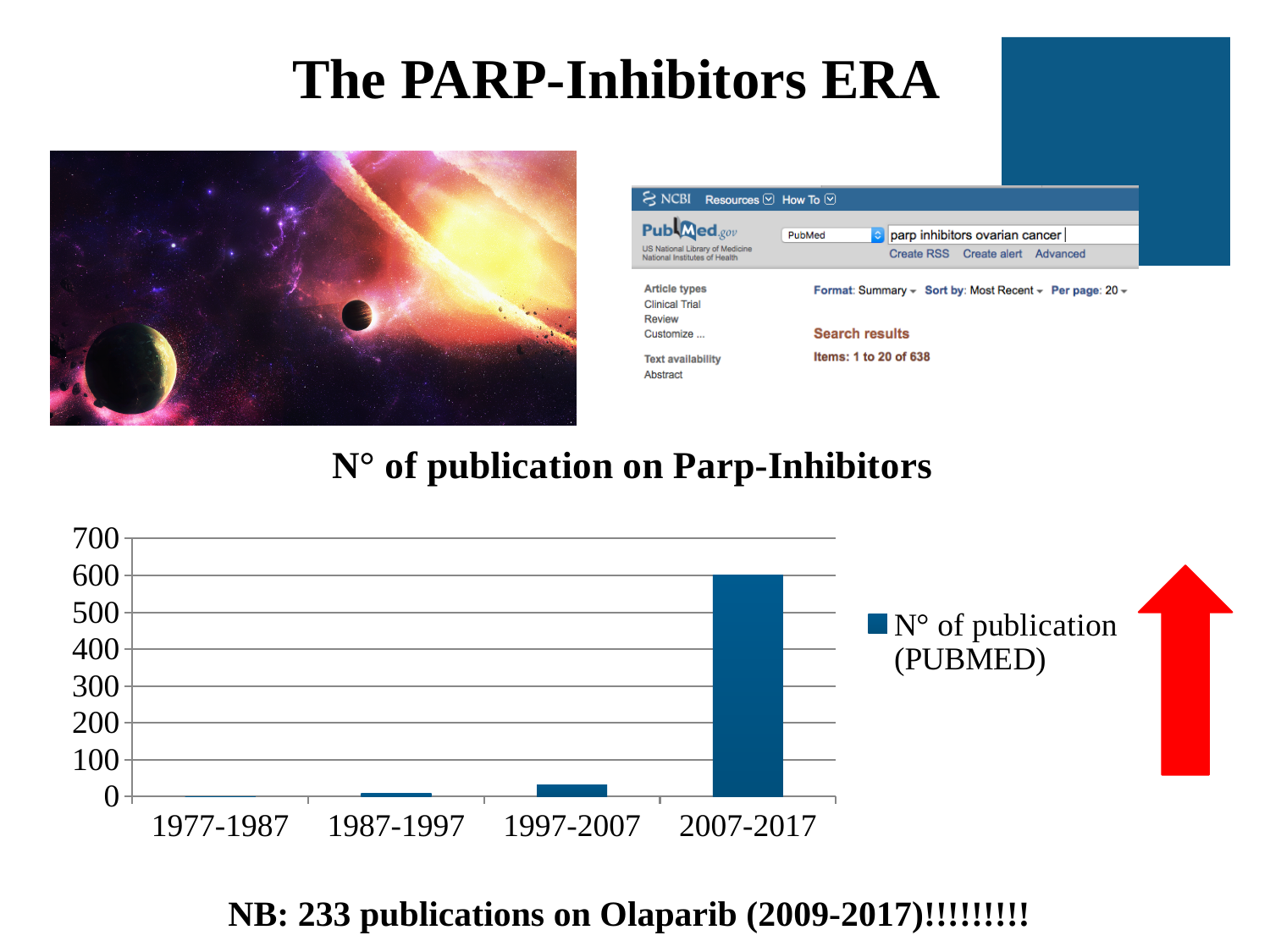
Which is larger, the value for 1997-2007 or the value for 1987-1997? 1997-2007 Is the value for 1997-2007 greater or less than 100? less Is the value for 2007-2017 greater or less than 500? greater What kind of chart is shown on the slide? bar chart What is the title of the chart? N° of publication on Parp-Inhibitors What is the legend entry for the series in the chart? N° of publication (PUBMED) Do the values rise or fall from 1977-1987 to 2007-2017? rise Is the value for 1987-1997 greater or less than 100? less Which period has the lowest number of publications? 1977-1987 How many time-period categories are shown on the x axis of the chart? 4 How many series does the chart legend list? 1 Which period has the highest number of publications? 2007-2017